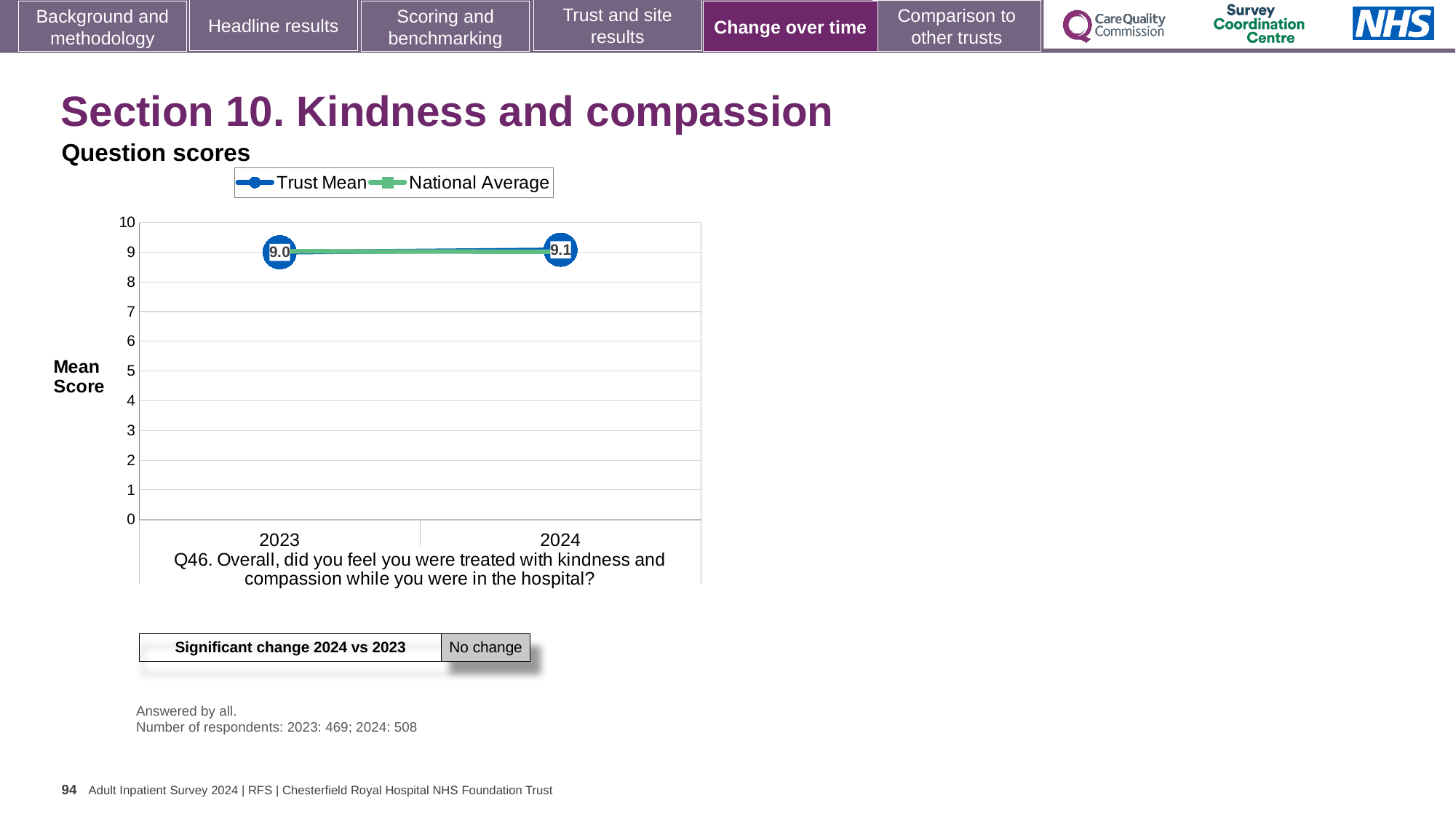
What is the label on the y axis of the chart? Mean Score Is the Trust Mean for 2023 greater or less than 8? greater What is the Trust Mean for 2023? 9.0 How many series does the legend list? 2 What kind of chart is shown? line chart What is the Trust Mean for 2024? 9.1 How many years are plotted on the x axis? 2 What is the difference between the Trust Mean in 2024 and in 2023? 0.1 Does the Trust Mean rise or fall from 2023 to 2024? rise Is the National Average value for 2024 greater or less than 5? greater What are the two series named in the legend? Trust Mean and National Average Which year has the higher Trust Mean, 2023 or 2024? 2024